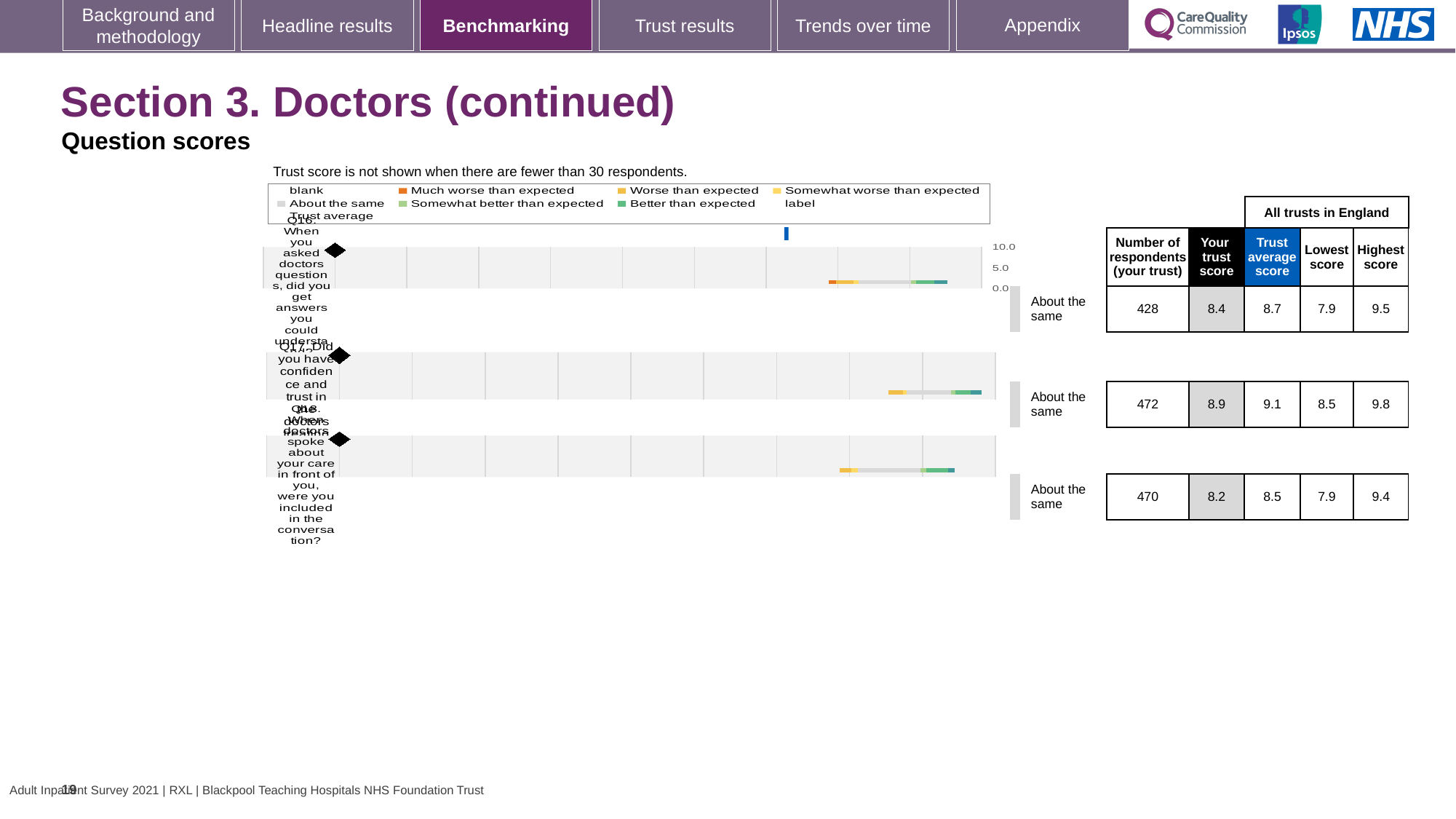
Which of the three questions has the highest trust score? Q17 What is the difference between the trust average score and this trust's score for Q16? 0.3 Which of the three questions has the lowest trust score? Q18 What is the trust average score for Q18 (being included in the conversation when doctors spoke about your care)? 8.5 How many questions (categories) are plotted in the chart? 3 What is the highest score across all trusts in England for Q17? 9.8 Is the trust score for Q17 greater or less than 5.0 on the chart's axis? greater What kind of chart is used to show the question scores on this slide? bar chart What is the trust score for Q16 (getting answers you could understand from doctors)? 8.4 What is the maximum value shown on the chart's score axis? 10.0 What is the trust score for Q17 (confidence and trust in the doctors)? 8.9 How many respondents answered Q17 at this trust? 472